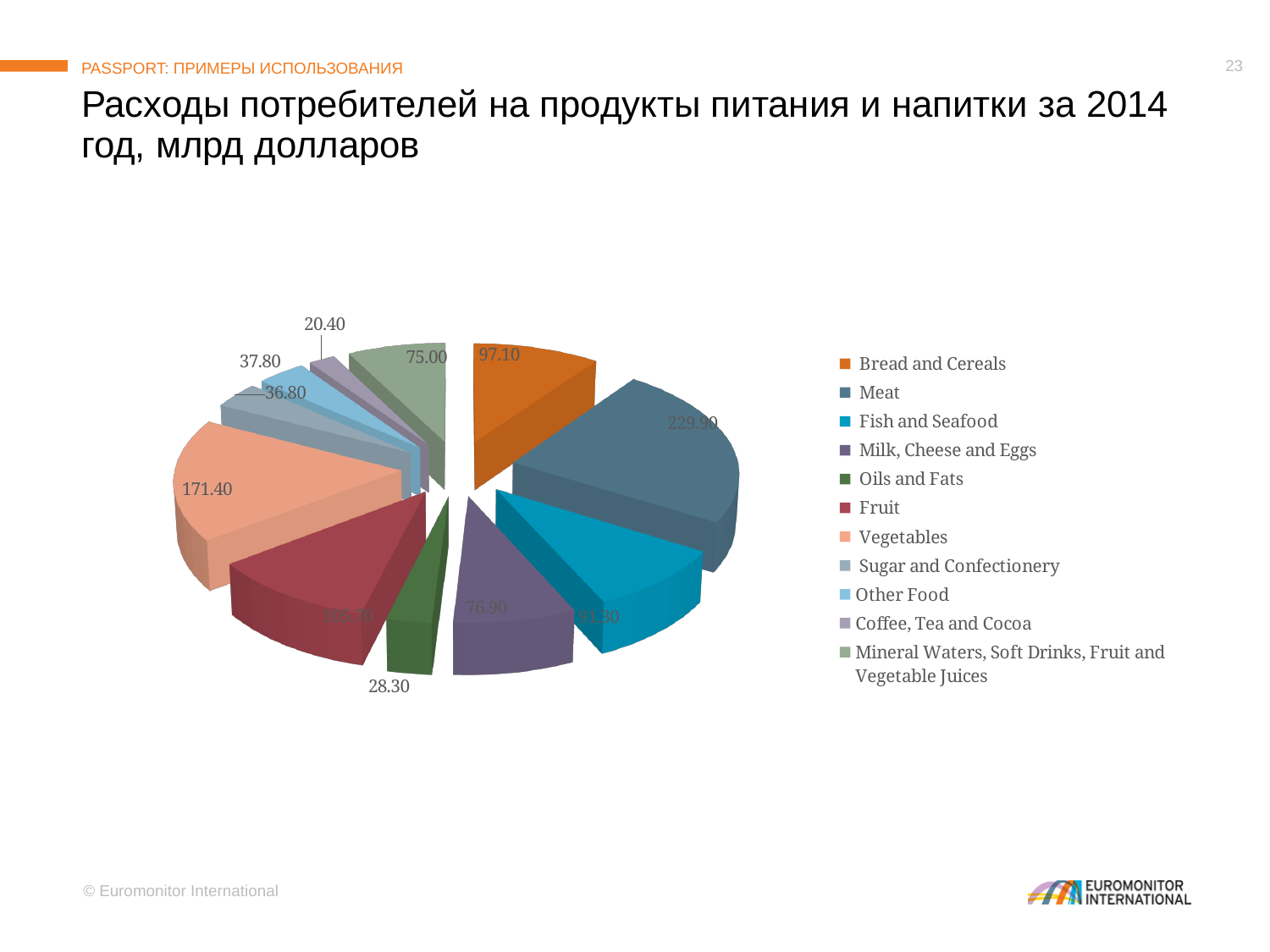
Which is larger: the value for Bread and Cereals or the value for Mineral Waters, Soft Drinks, Fruit and Vegetable Juices? Bread and Cereals What is the difference between the values for Meat and Vegetables? 58.50 Which category has the smallest slice in the pie chart? Coffee, Tea and Cocoa What is the value for Coffee, Tea and Cocoa in the pie chart? 20.40 How many categories does the legend of the pie chart list? 11 Which category has the largest slice in the pie chart? Meat What type of chart is shown on the slide? pie chart What is the value for Oils and Fats in the pie chart? 28.30 What is the value for Meat in the pie chart? 229.90 What is the value for Vegetables in the pie chart? 171.40 What is the value for Bread and Cereals in the pie chart? 97.10 What is the value for Mineral Waters, Soft Drinks, Fruit and Vegetable Juices in the pie chart? 75.00